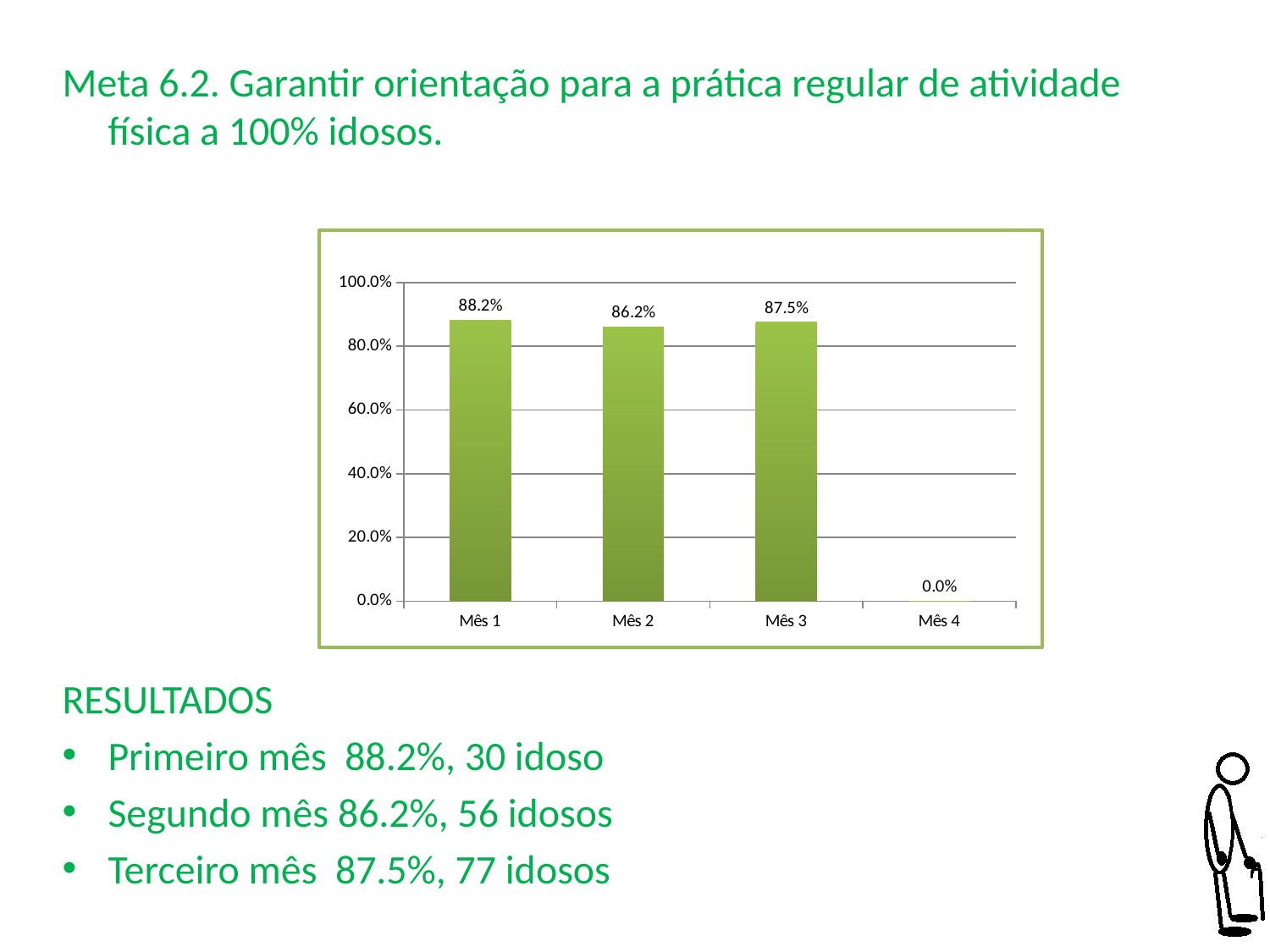
What is the value for Mês 2? 86.2% Which month has the lowest value? Mês 4 What is the value for Mês 1? 88.2% What is the difference between the values for Mês 1 and Mês 2? 2.0% What is the difference between the values for Mês 3 and Mês 2? 1.3% Which month has the highest value? Mês 1 What is the value for Mês 4? 0.0% Is the value for Mês 2 greater or less than 80.0%? greater What kind of chart is shown on the slide? Bar chart Which is larger, the value for Mês 1 or the value for Mês 3? Mês 1 What is the value for Mês 3? 87.5% How many categories are shown on the x axis? 4